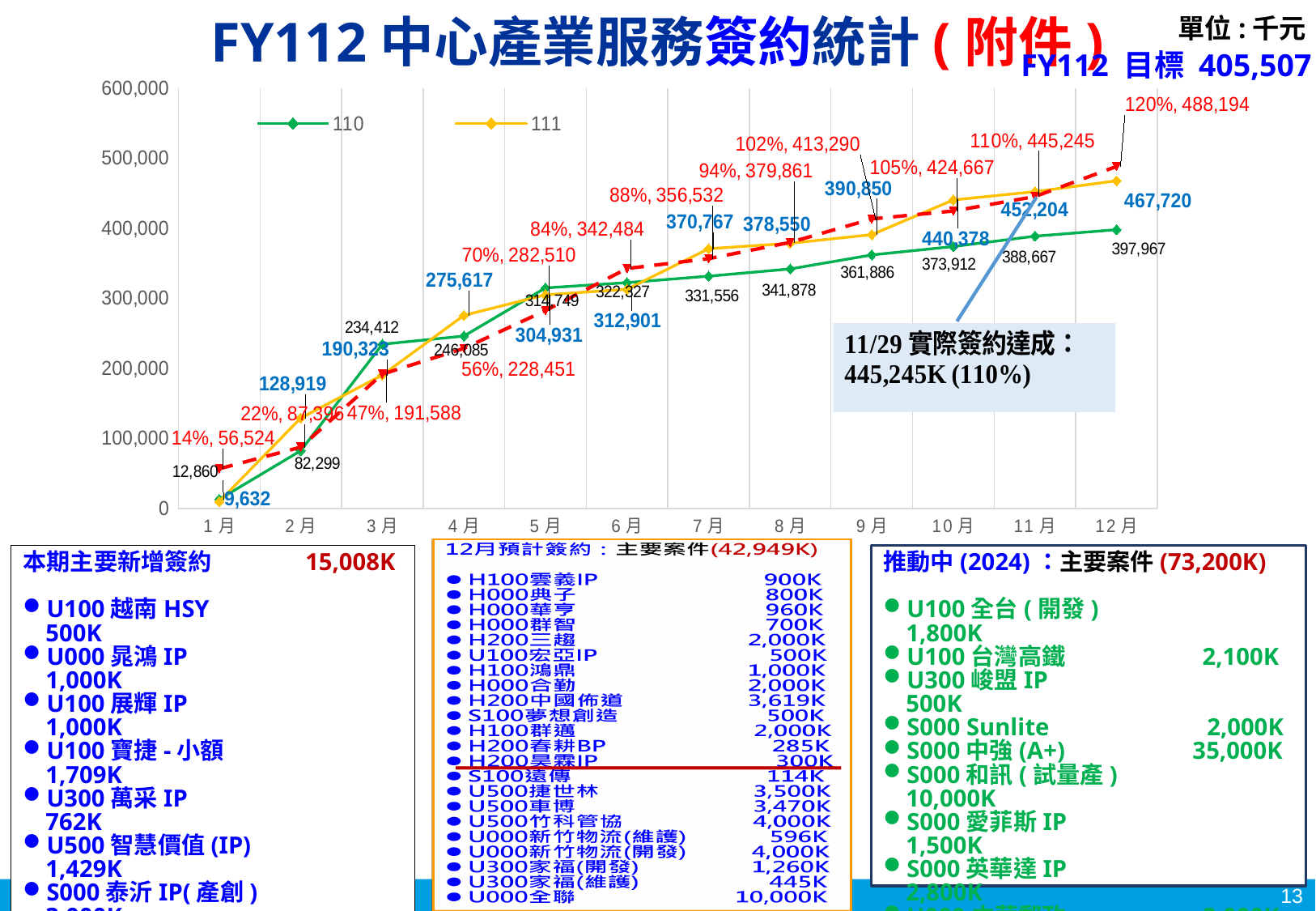
How many series does the legend list? 2 What is the difference between the 111 and 110 series values in 12月? 69,753 What is the value of the 110 series in 12月? 397,967 What is the value of the 111 series in 12月? 467,720 In which month is the 110 series at its lowest value? 1月 What is the value of the 110 series in 1月? 12,860 What is the data label on the red dashed line at 11月? 110%, 445,245 What is the value of the 111 series in 2月? 128,919 In 3月, which series has the larger value, 110 or 111? 110 How many months are plotted on the x axis? 12 What kind of chart is shown on the slide? line chart In which month does the 111 series reach its highest value? 12月